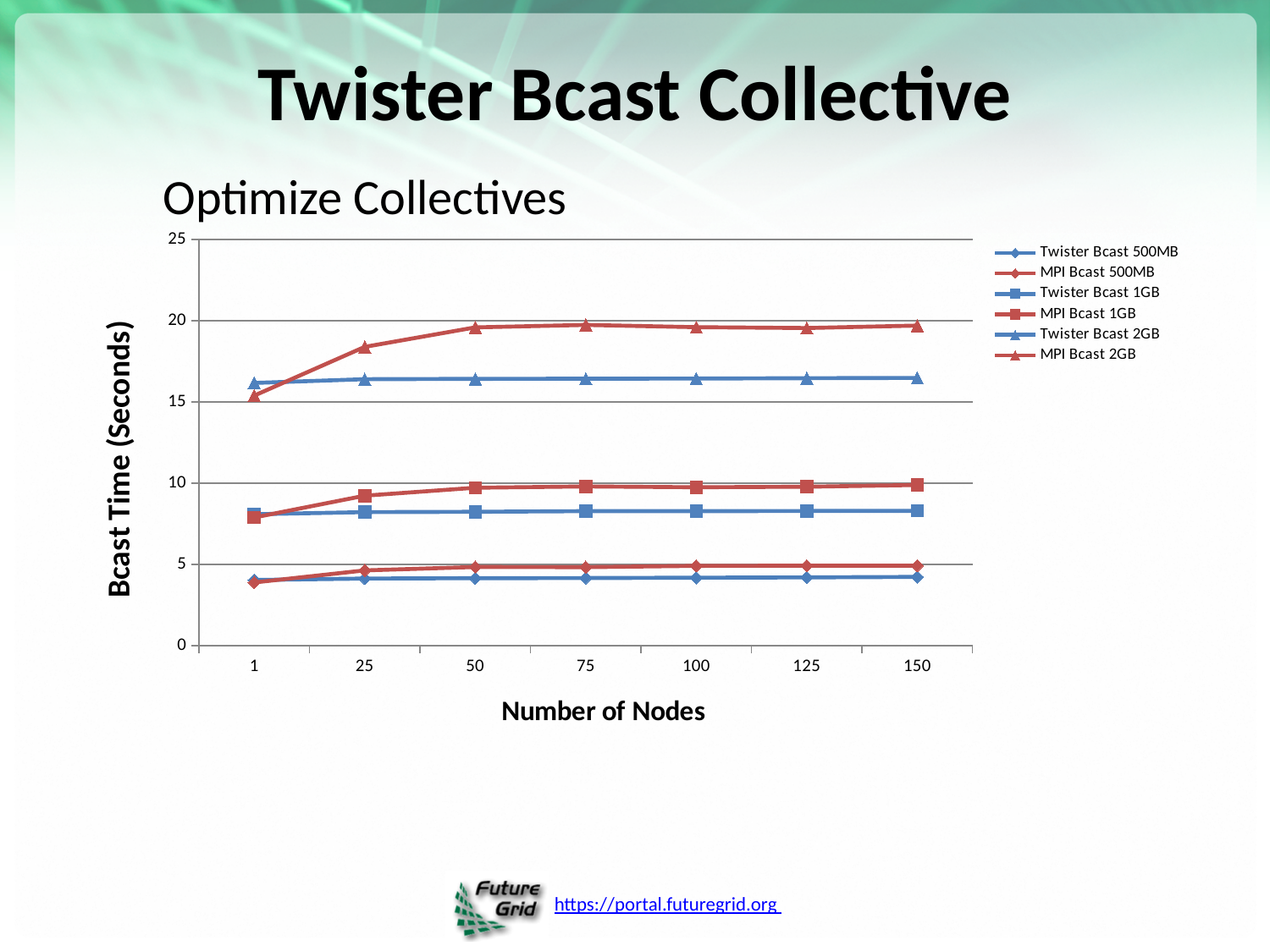
Which series has the highest Bcast time at 150 nodes? MPI Bcast 2GB Is the value for Twister Bcast 1GB at 50 nodes greater or less than 10? less How many node counts are plotted along the x axis? 7 Is the value for MPI Bcast 2GB at 150 nodes greater or less than 15? greater Does the MPI Bcast 2GB line rise or fall from 1 node to 50 nodes? rise At 150 nodes, which is larger: MPI Bcast 2GB or Twister Bcast 2GB? MPI Bcast 2GB What is the title of the y axis? Bcast Time (Seconds) At 1 node, which is larger: Twister Bcast 2GB or MPI Bcast 2GB? Twister Bcast 2GB Is the value for Twister Bcast 500MB at 1 node greater or less than 5? less What kind of chart is shown on the slide? line chart How many series does the legend list? 6 Which series has the lowest Bcast time at 150 nodes? Twister Bcast 500MB